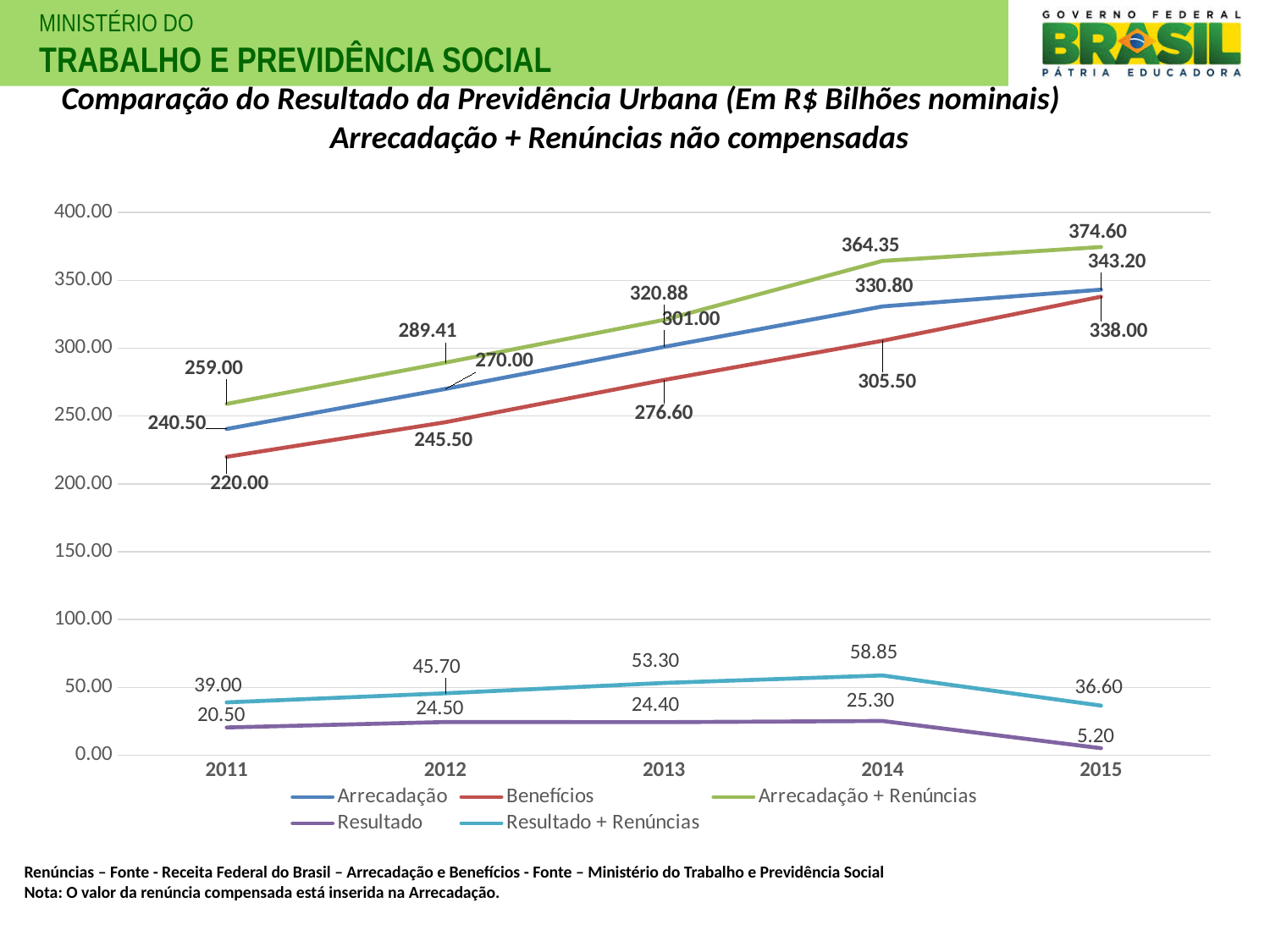
How many series does the legend list? 5 What is the difference between Arrecadação and Benefícios in 2011? 20.50 What type of chart is shown on the slide? line chart In which year is Resultado + Renúncias highest? 2014 What is the value of Resultado in 2015? 5.20 Does the Benefícios series rise or fall from 2011 to 2015? rise What is the value of Benefícios in 2015? 338.00 What is the value of Arrecadação in 2013? 301.00 Which is larger in 2012: Arrecadação + Renúncias or Arrecadação? Arrecadação + Renúncias In which year is Resultado lowest? 2015 What is the value of Arrecadação + Renúncias in 2014? 364.35 How many years are plotted on the x axis? 5